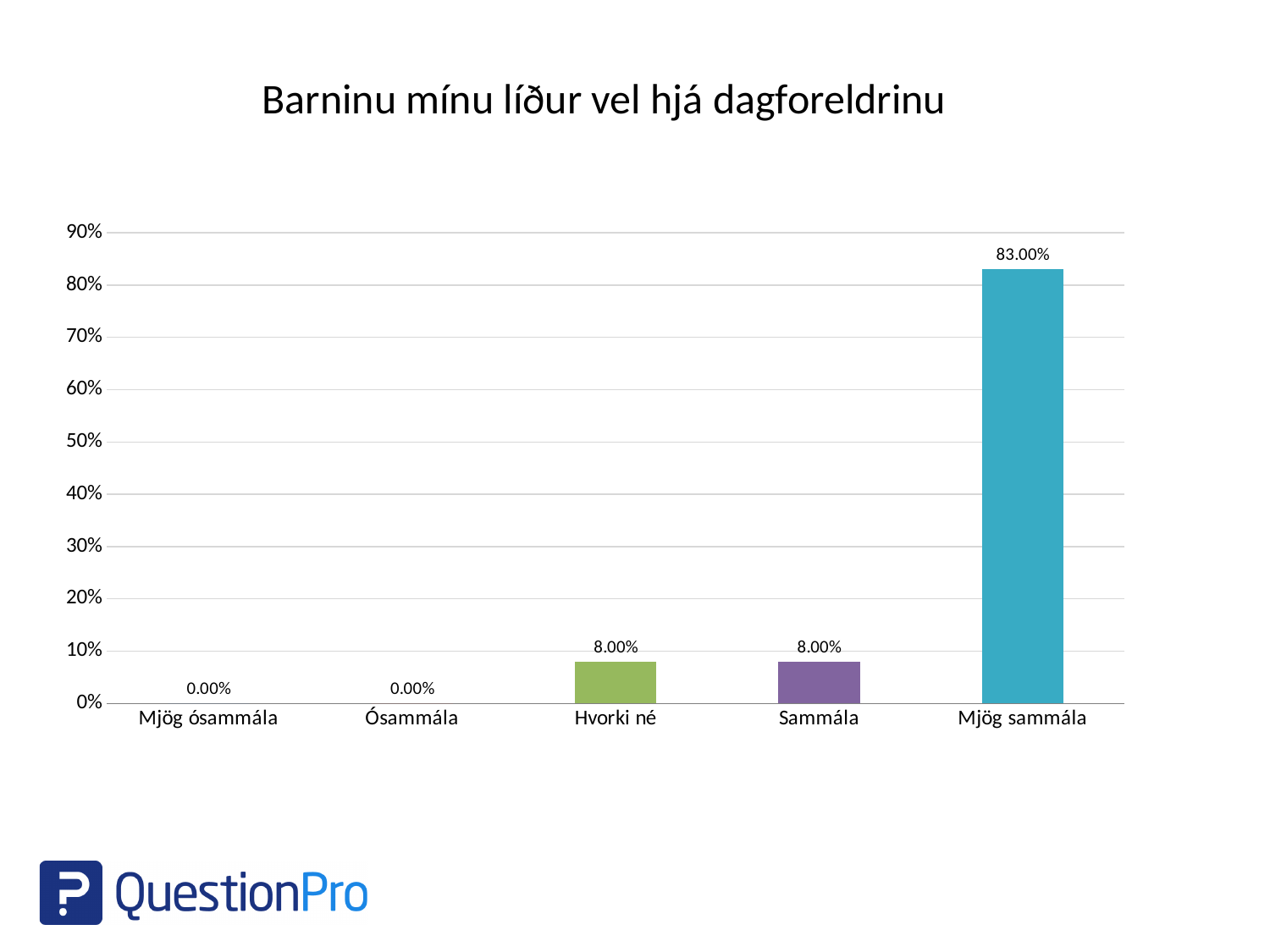
What is the value for Mjög ósammála? 0.00% What is the difference between the values for Mjög sammála and Sammála? 75.00% What is the value for Sammála? 8.00% What is the title of the chart? Barninu mínu líður vel hjá dagforeldrinu Which category has the highest value? Mjög sammála What is the value for Mjög sammála? 83.00% Is the value for Mjög sammála greater or less than 80%? greater What is the highest value shown on the y axis? 90% What kind of chart is shown on the slide? bar chart What is the value for Hvorki né? 8.00% How many categories are shown on the x axis? 5 Which is larger, the value for Hvorki né or the value for Ósammála? Hvorki né